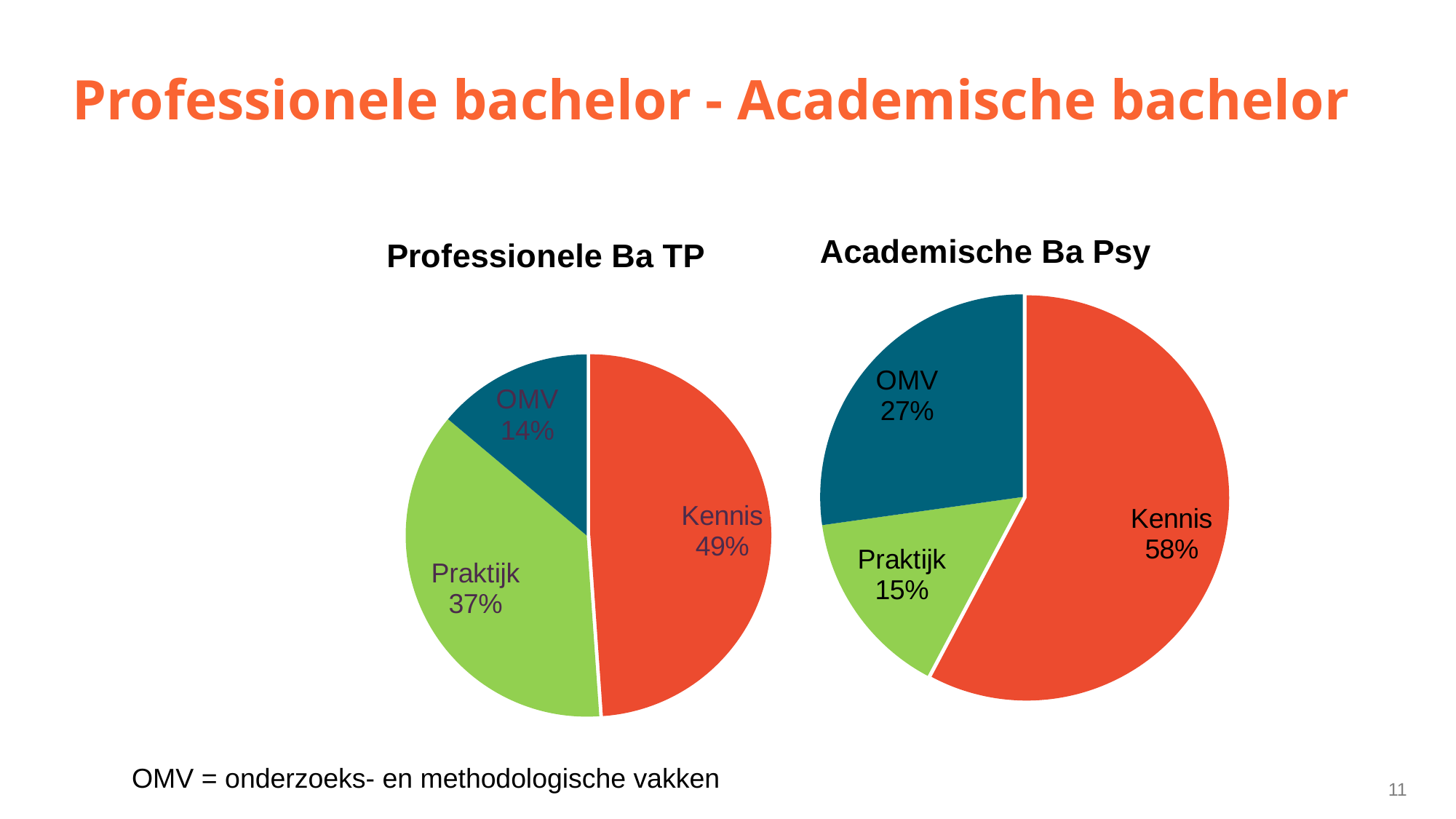
In the 'Professionele Ba TP' chart, what share does OMV have? 14% In the 'Academische Ba Psy' chart, which category has the smallest slice? Praktijk What type of chart is the 'Academische Ba Psy' chart? Pie chart In the 'Professionele Ba TP' chart, what share does Kennis have? 49% In the 'Professionele Ba TP' chart, which category has the largest slice? Kennis Which is larger: the OMV share in the 'Academische Ba Psy' chart or the OMV share in the 'Professionele Ba TP' chart? Academische Ba Psy In the 'Academische Ba Psy' chart, what share does OMV have? 27% In the 'Professionele Ba TP' chart, what share does Praktijk have? 37% How many slices does the 'Professionele Ba TP' chart have? 3 What is the difference between the Praktijk share in the 'Professionele Ba TP' chart and the Praktijk share in the 'Academische Ba Psy' chart? 22% In the 'Academische Ba Psy' chart, what share does Kennis have? 58% In the 'Academische Ba Psy' chart, what share does Praktijk have? 15%